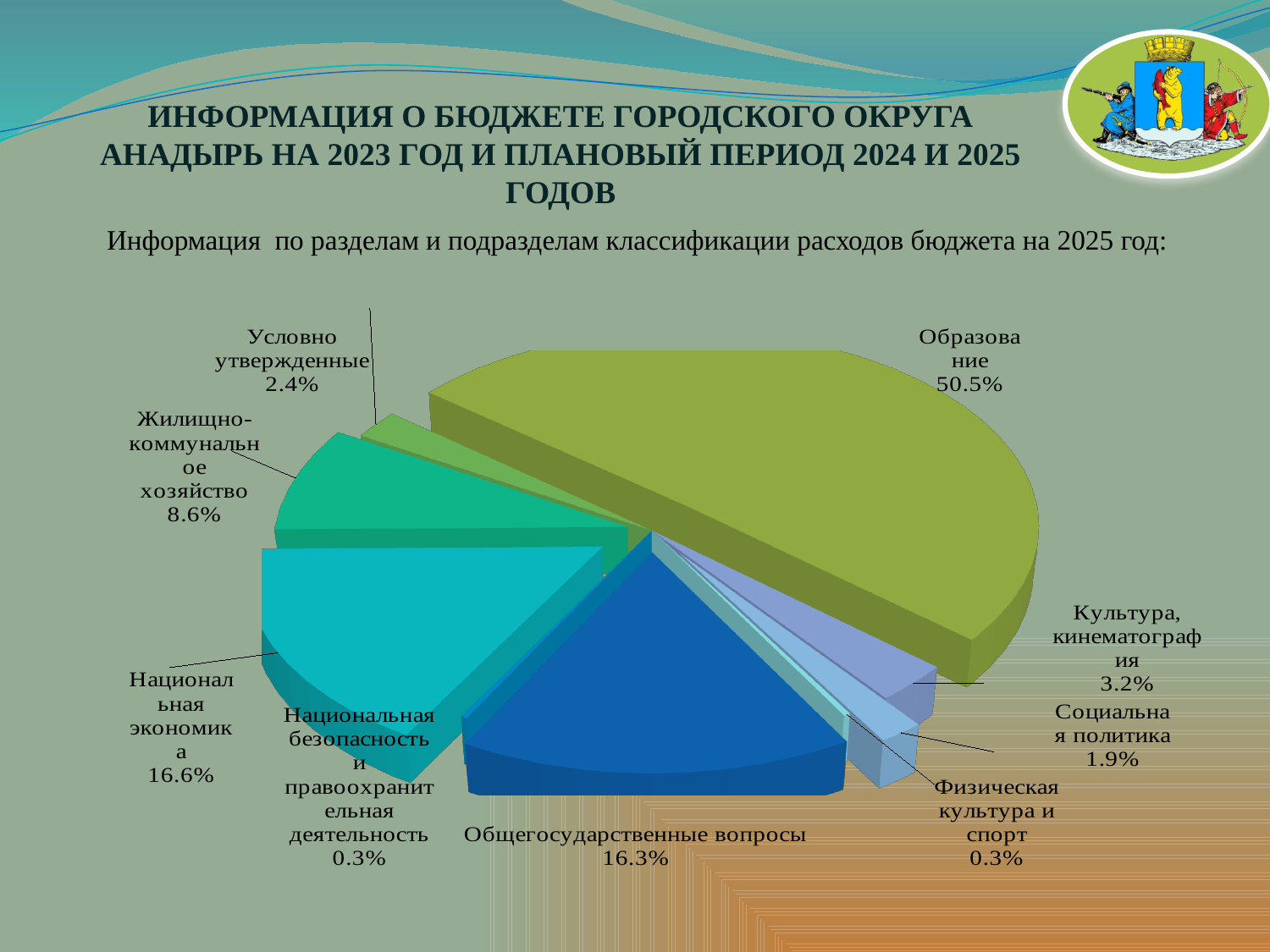
What percentage is shown for Жилищно-коммунальное хозяйство? 8.6% How many sections are shown in the pie chart? 9 What percentage is shown for Условно утвержденные? 2.4% What share of the 2025 budget expenditures goes to Образование? 50.5% Which is larger: Национальная экономика or Общегосударственные вопросы? Национальная экономика What is the difference between the shares of Культура, кинематография and Социальная политика? 1.3% What type of chart is shown on the slide? Pie chart What percentage is shown for Социальная политика? 1.9% Which year does the chart's expenditure breakdown refer to? 2025 Which section has the largest share of the pie? Образование What percentage is shown for Национальная экономика? 16.6% What is the difference between the shares of Образование and Национальная экономика? 33.9%